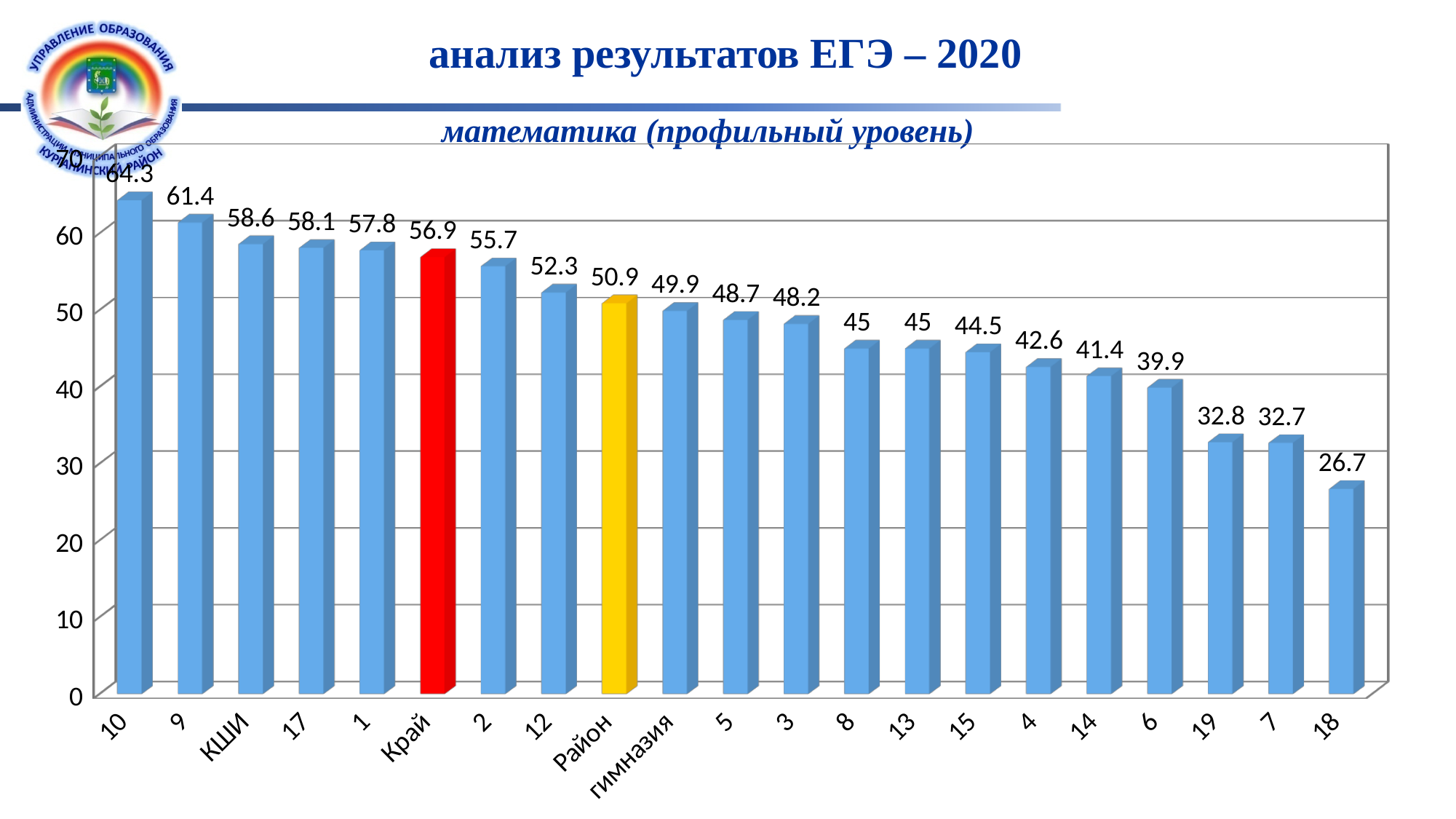
Which category has the highest value? 10 What kind of chart is shown on the slide? bar chart What is the value for Край? 56.9 What is the value for гимназия? 49.9 What colour is the bar for Край? red What is the value for Район? 50.9 How many categories are shown on the x axis? 21 What is the value for school 10? 64.3 Which category has the lowest value? 18 Which is larger, the value for КШИ or the value for school 2? КШИ What is the difference between the values for Край and Район? 6 Do the values rise or fall from left to right along the x axis? fall